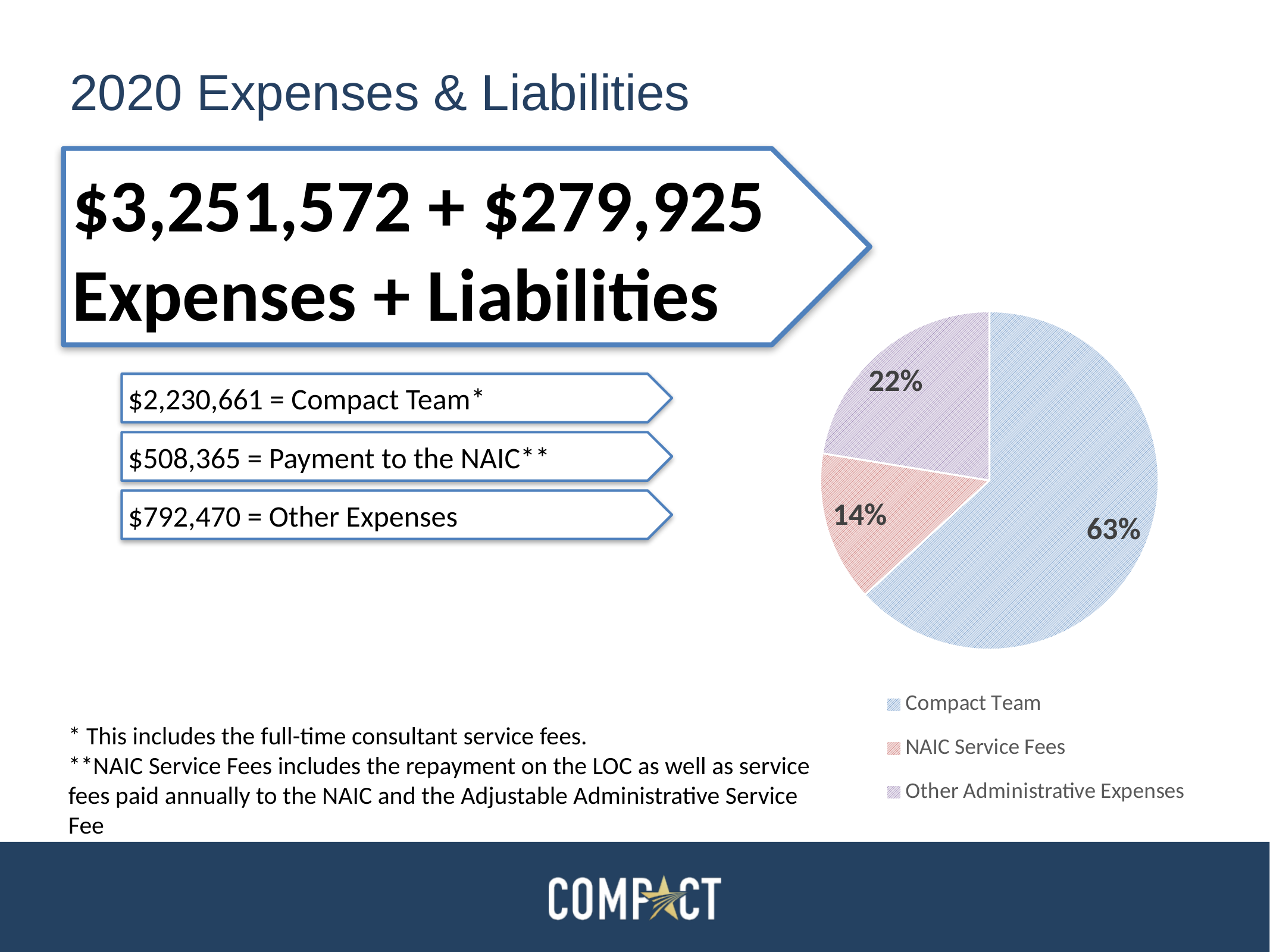
What share of the pie does Other Administrative Expenses represent? 22% Which is larger, the Other Administrative Expenses slice or the NAIC Service Fees slice? Other Administrative Expenses What is the difference in percentage points between the Compact Team slice and the Other Administrative Expenses slice? 41 How many slices does the pie chart have? 3 What share of the pie does NAIC Service Fees represent? 14% What share of the pie does Compact Team represent? 63% What is the difference in percentage points between the Other Administrative Expenses slice and the NAIC Service Fees slice? 8 Which slice of the pie chart is the smallest? NAIC Service Fees How many entries does the legend list? 3 Which legend entry is shown in blue? Compact Team What kind of chart is shown on the slide? pie chart Which slice of the pie chart is the largest? Compact Team